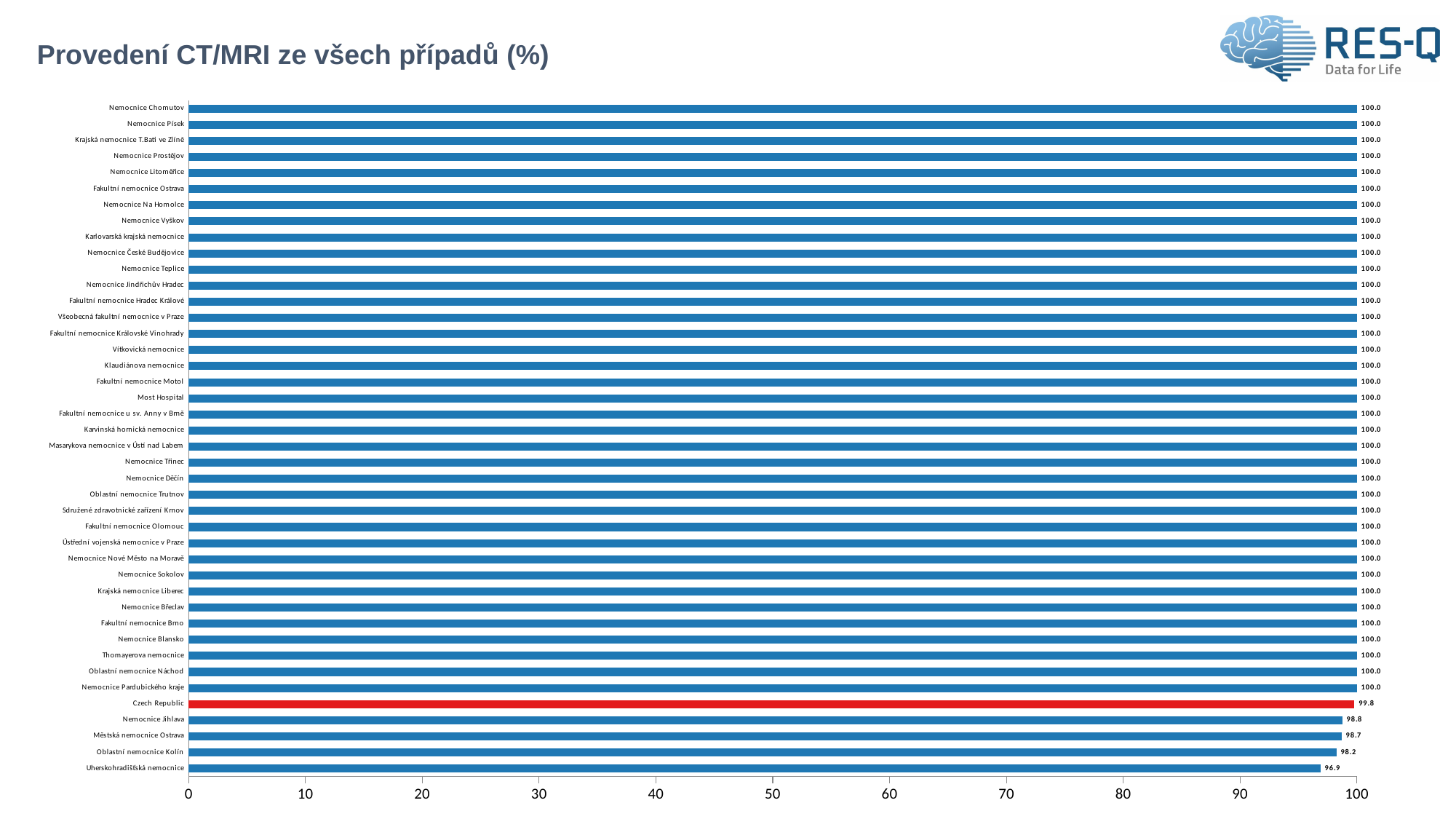
What is the title of the chart? Provedení CT/MRI ze všech případů (%) What is the value for Uherskohradišťská nemocnice? 96.9 What is the difference between the values for Nemocnice Jihlava and Oblastní nemocnice Kolín? 0.6 Which is larger, the value for Nemocnice Jihlava or the value for Uherskohradišťská nemocnice? Nemocnice Jihlava What is the value for Czech Republic? 99.8 What is the value for Městská nemocnice Ostrava? 98.7 What kind of chart is shown on the slide? bar chart What is the difference between the values for Czech Republic and Uherskohradišťská nemocnice? 2.9 What is the value for Oblastní nemocnice Kolín? 98.2 Which category's bar is coloured red instead of blue? Czech Republic What is the value for Nemocnice Jihlava? 98.8 Which category has the lowest value? Uherskohradišťská nemocnice